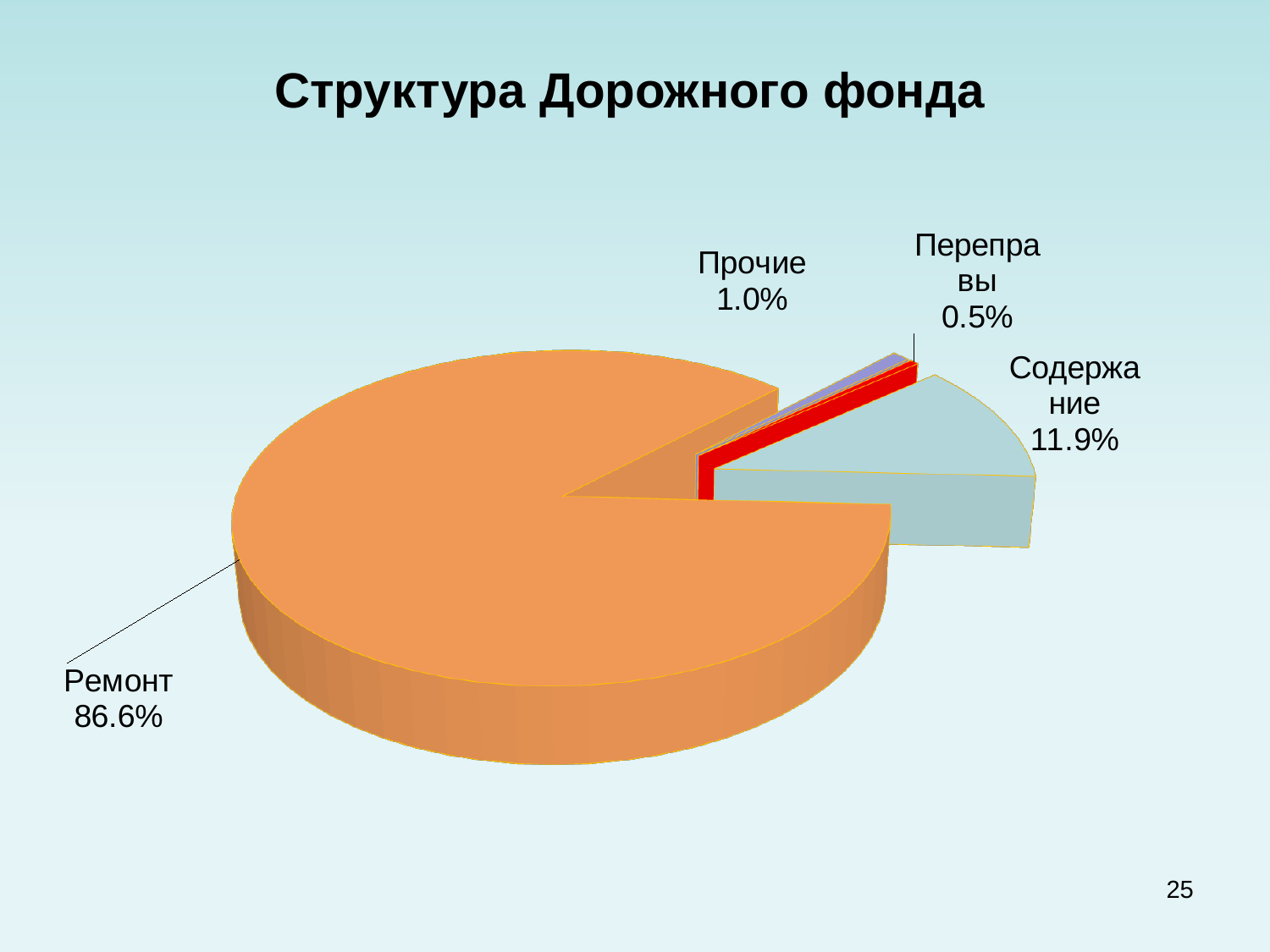
What is the difference between the shares of Ремонт and Содержание? 74.7% What colour is the Ремонт slice? Orange Which is larger, the share of Прочие or the share of Переправы? Прочие What share of the pie does Переправы have? 0.5% What share of the pie does Прочие have? 1.0% What share of the pie does Содержание have? 11.9% Which category has the smallest share of the pie? Переправы What is the title of the chart? Структура Дорожного фонда What share of the pie does Ремонт have? 86.6% How many slices does the pie chart have? 4 What kind of chart is shown on the slide? Pie chart Which category has the largest share of the pie? Ремонт